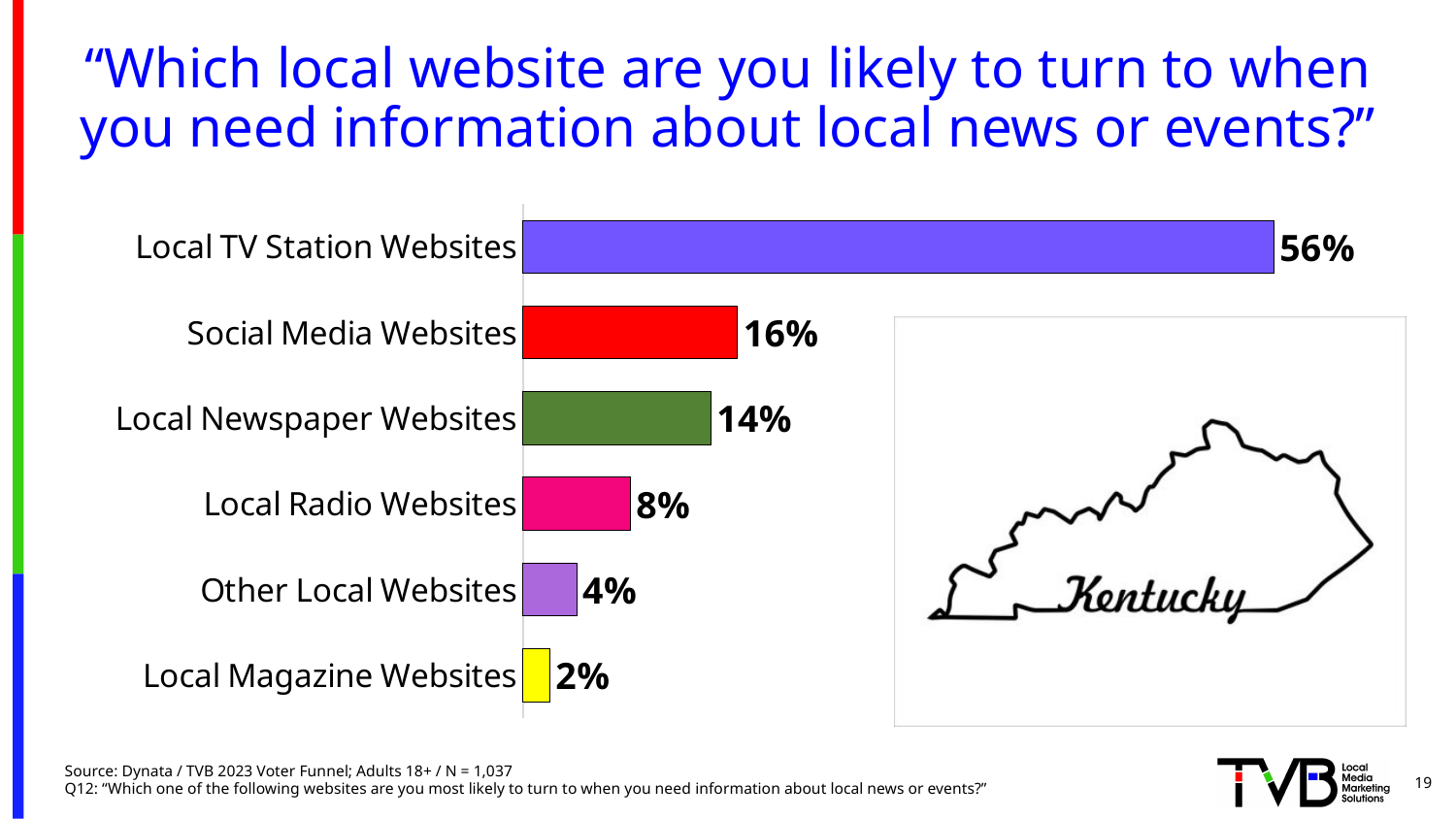
Which is larger, the value for Social Media Websites or Local Newspaper Websites? Social Media Websites Which state is shown in the map outline next to the chart? Kentucky What is the value shown for Social Media Websites? 16% What is the value shown for Local Magazine Websites? 2% Which category has the highest value? Local TV Station Websites What is the difference between the values for Local Newspaper Websites and Local Radio Websites? 6% Which category has the lowest value? Local Magazine Websites What kind of chart is shown on the slide? Bar chart What is the difference between the values for Local TV Station Websites and Social Media Websites? 40% What percentage of respondents said they would turn to Local TV Station Websites? 56% How many categories are shown in the chart? 6 What is the value shown for Local Radio Websites? 8%